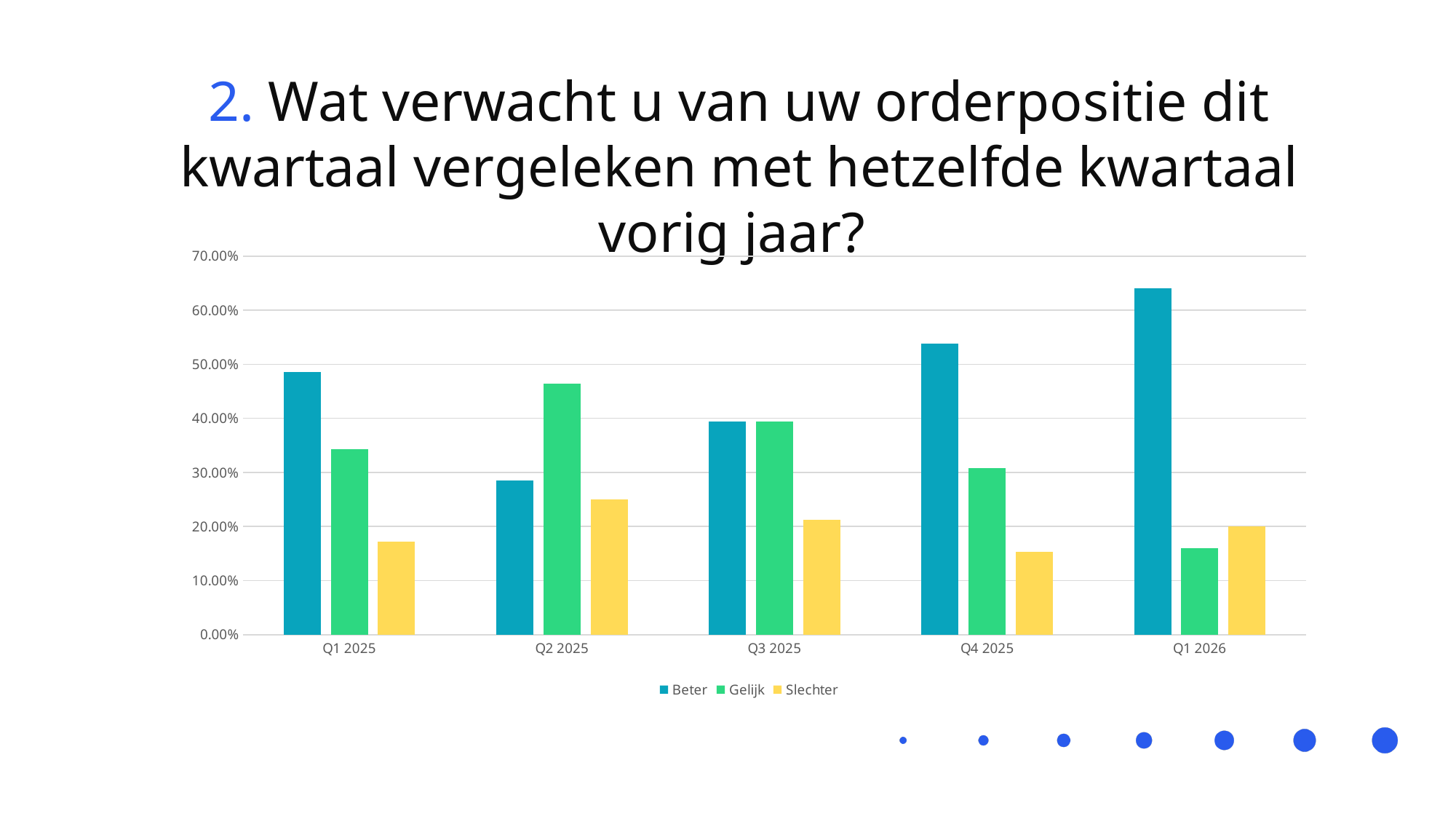
In which quarter is the value for Gelijk highest? Q2 2025 How many quarters are shown on the x axis? 5 In which quarter is the value for Slechter highest? Q2 2025 Does the value for Beter rise or fall from Q3 2025 to Q1 2026? rise In which quarter is the value for Beter highest? Q1 2026 In Q1 2026, which is larger: Gelijk or Slechter? Slechter How many series does the legend list? 3 Is the value for Slechter in Q1 2025 greater or less than 20.00%? less In which quarter is the value for Beter lowest? Q2 2025 Is the value for Beter in Q1 2026 greater or less than 60.00%? greater What kind of chart is shown on the slide? bar chart In Q2 2025, which is larger: Beter or Gelijk? Gelijk